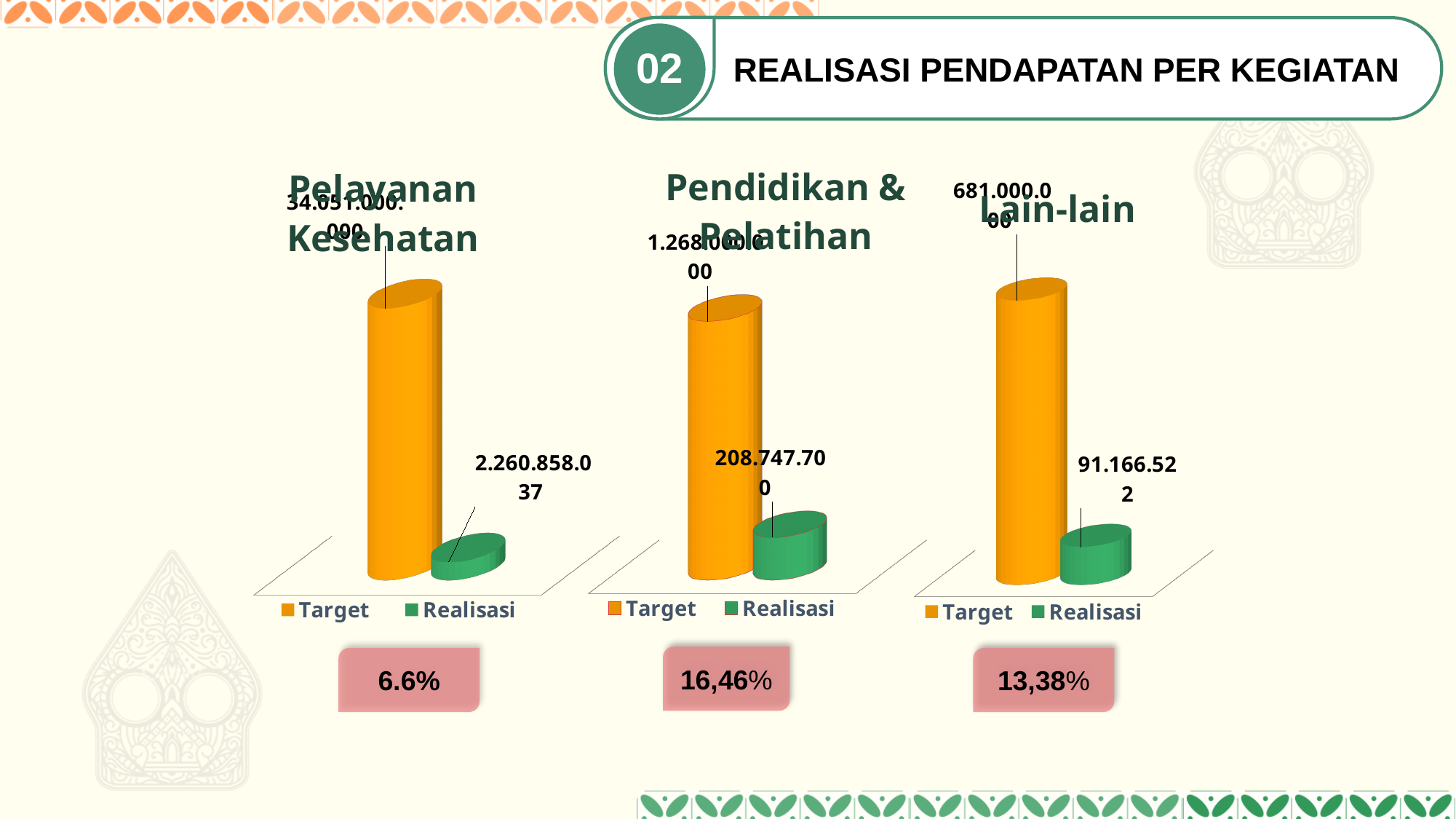
How many charts are shown on the slide? 3 What kind of chart is the "Pelayanan Kesehatan" chart? bar chart In the "Pendidikan & Pelatihan" chart, what colour represents the Target series? orange What percentage is shown in the box below the "Pendidikan & Pelatihan" chart? 16,46% In the "Lain-lain" chart, what is the difference between Target and Realisasi? 589.833.478 In the "Lain-lain" chart, what is the value of Target? 681.000.000 How many series does the legend of the "Lain-lain" chart list? 2 In the "Pendidikan & Pelatihan" chart, what is the value of Realisasi? 208.747.700 In the "Pendidikan & Pelatihan" chart, which series has the lowest value? Realisasi In the "Pelayanan Kesehatan" chart, what is the value of Realisasi? 2.260.858.037 In the "Lain-lain" chart, what is the value of Realisasi? 91.166.522 In the "Pelayanan Kesehatan" chart, which is larger, Target or Realisasi? Target